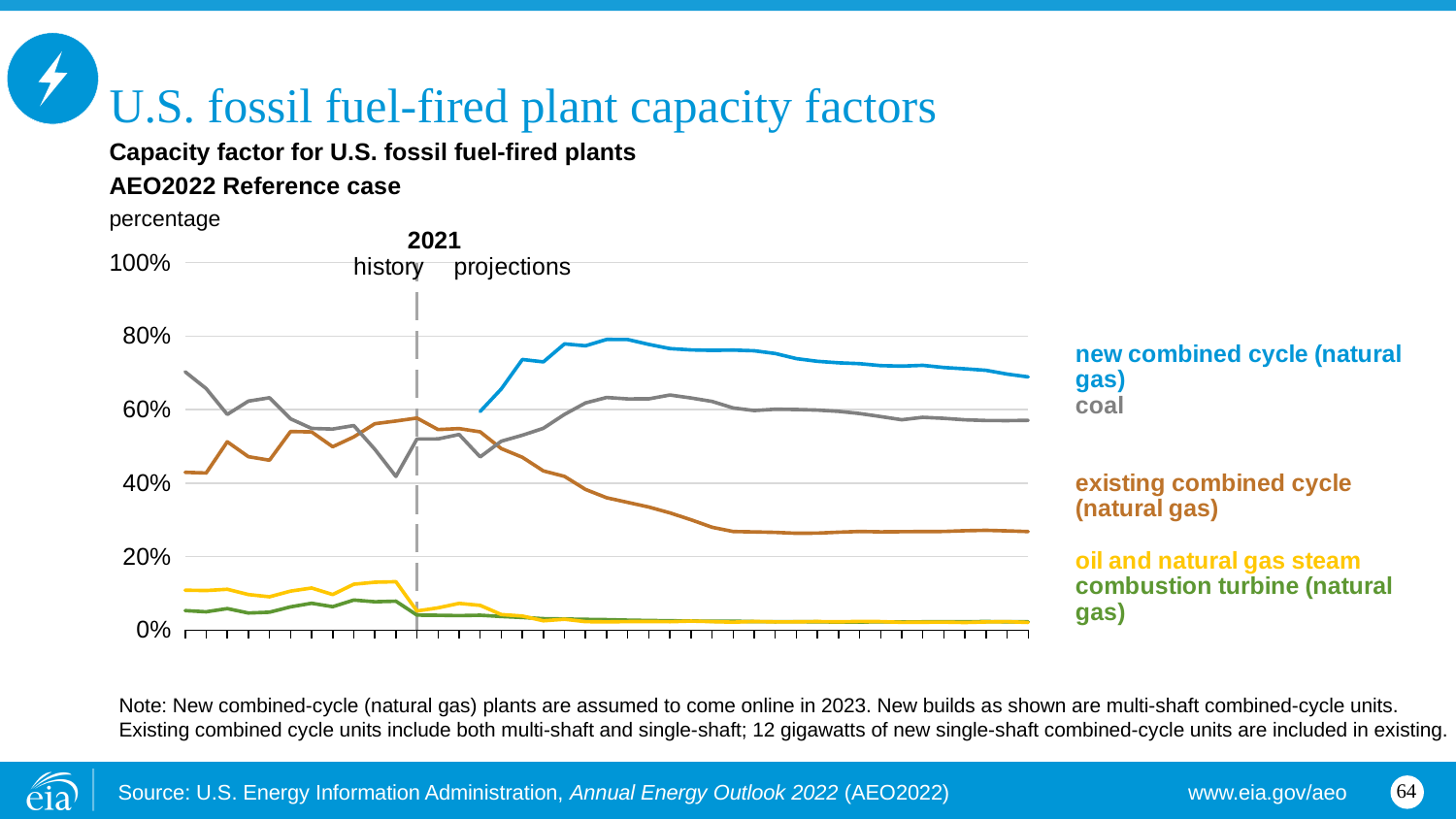
At the end of the projections, which is larger: the capacity factor for coal or for existing combined cycle (natural gas)? coal What kind of chart is shown on the slide? line chart What unit is the y axis measured in? percentage What year does the dashed vertical line separating history from projections mark? 2021 Which series has the highest capacity factor at the end of the projection period? new combined cycle (natural gas) Does the capacity factor for new combined cycle (natural gas) rise or fall after its peak near 80%? fall How many series are labelled on the chart? 5 Is the capacity factor for new combined cycle (natural gas) at the end of the projections greater or less than 60%? greater Does the capacity factor for existing combined cycle (natural gas) rise or fall over the projection period? fall Is the capacity factor for existing combined cycle (natural gas) at the end of the projections greater or less than 40%? less Is the capacity factor for coal at the end of the projections greater or less than 40%? greater